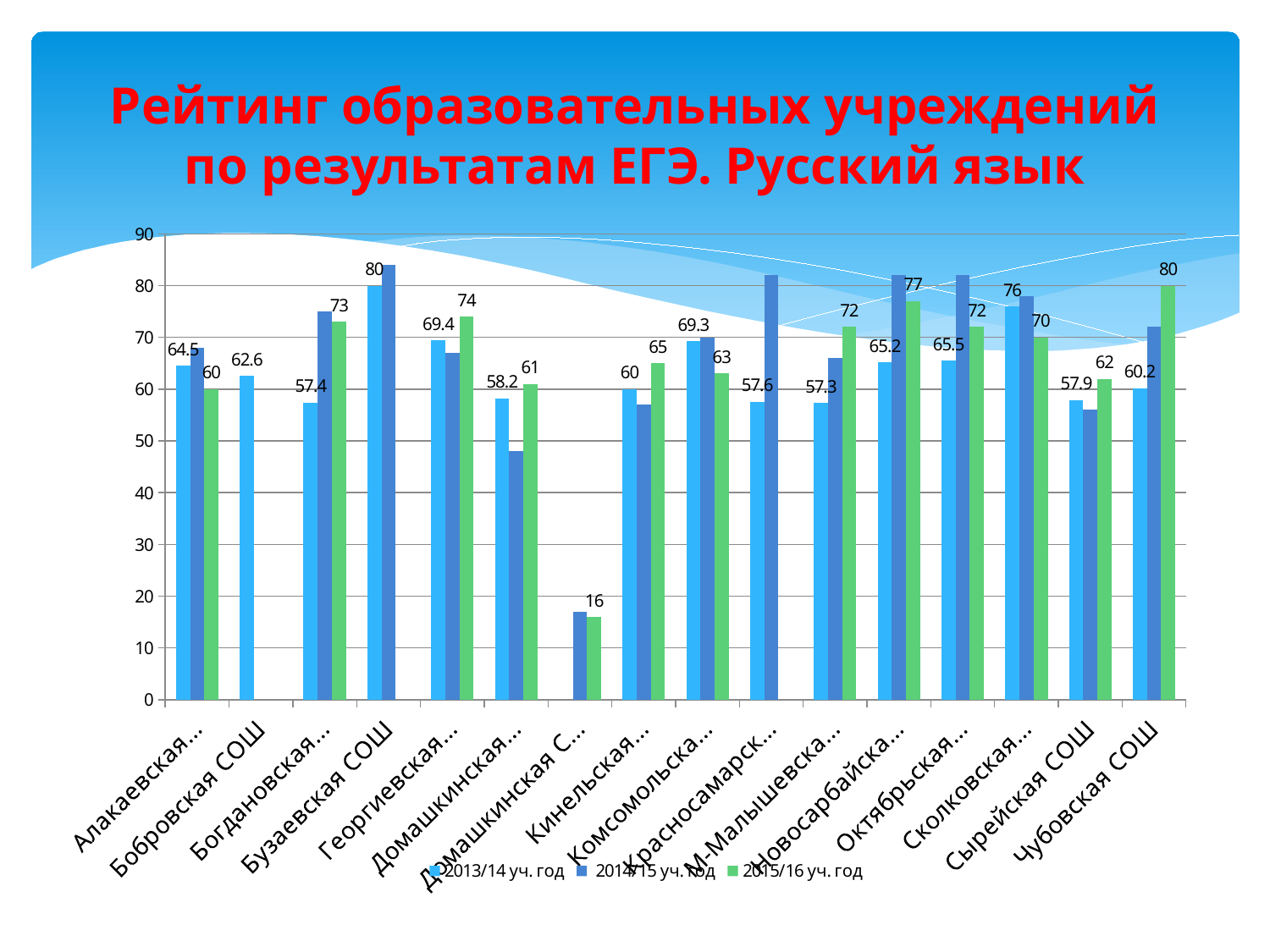
For Сырейская СОШ, which series has the larger value: 2013/14 уч. год or 2015/16 уч. год? 2015/16 уч. год What is the difference between the 2015/16 уч. год value and the 2013/14 уч. год value for Чубовская СОШ? 19.8 Which school has the highest value in the 2013/14 уч. год series? Бузаевская СОШ Is the 2014/15 уч. год value for Бузаевская СОШ greater or less than 80? greater What is the value for Сырейская СОШ in the 2013/14 уч. год series? 57.9 What kind of chart is shown on the slide? bar chart What is the value for Бузаевская СОШ in the 2013/14 уч. год series? 80 What is the value for Чубовская СОШ in the 2015/16 уч. год series? 80 How many series does the legend list? 3 Is the 2014/15 уч. год value for Сырейская СОШ greater or less than 60? less How many schools (categories) are shown on the x axis? 16 What is the value for Бобровская СОШ in the 2013/14 уч. год series? 62.6